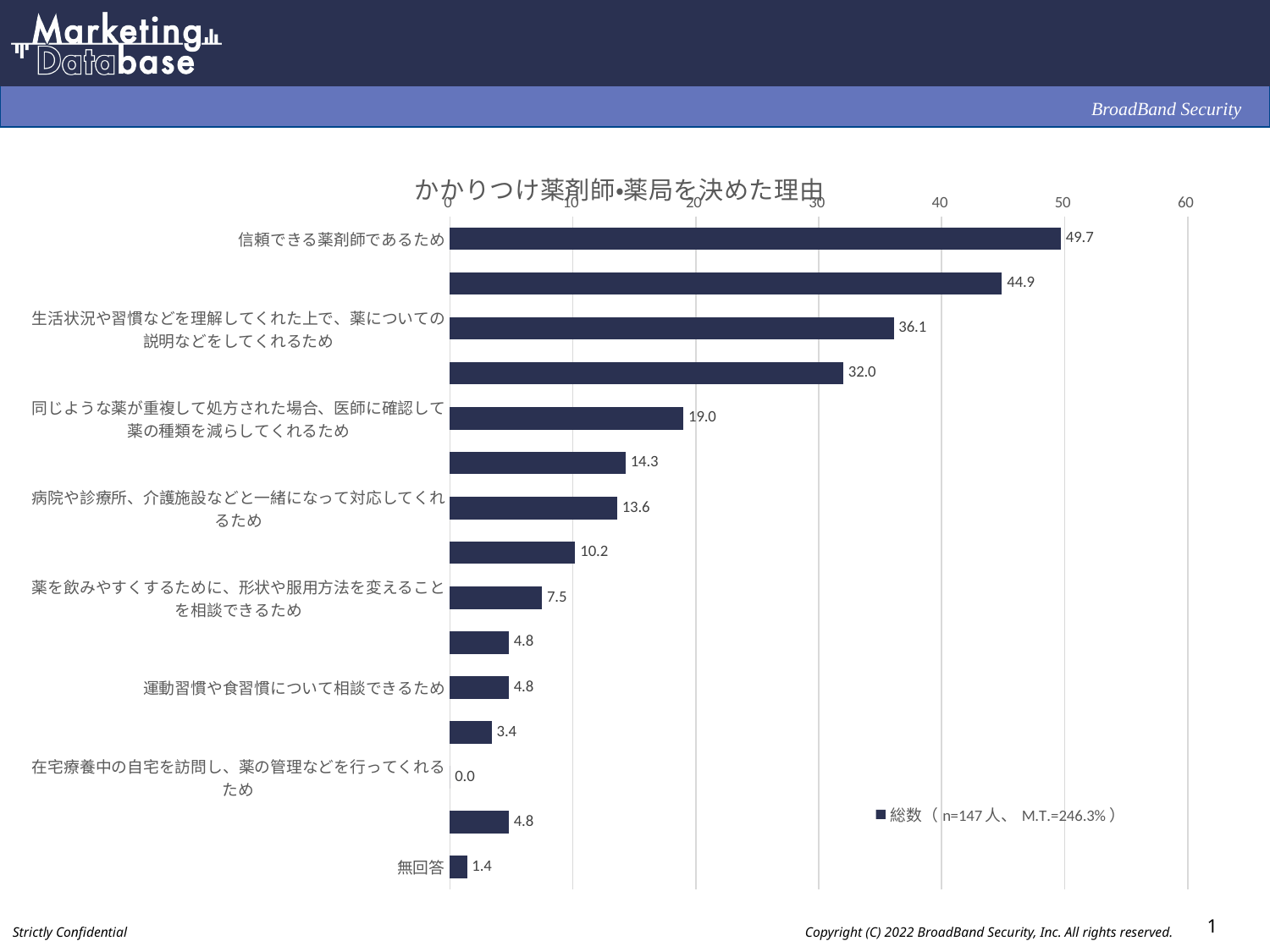
What is the value for 無回答? 1.4 What is the value for 生活状況や習慣などを理解してくれた上で、薬についての説明などをしてくれるため? 36.1 What is the difference between the values for 信頼できる薬剤師であるため and 生活状況や習慣などを理解してくれた上で、薬についての説明などをしてくれるため? 13.6 What is the value for 病院や診療所、介護施設などと一緒になって対応してくれるため? 13.6 What is the title of the chart? かかりつけ薬剤師•薬局を決めた理由 What is the value for 信頼できる薬剤師であるため? 49.7 How many series does the legend list? 1 What type of chart is shown on the slide? bar chart Which category has the highest value? 信頼できる薬剤師であるため How many bars are plotted in the chart? 15 Which is larger: the value for 同じような薬が重複して処方された場合、医師に確認して薬の種類を減らしてくれるため or the value for 病院や診療所、介護施設などと一緒になって対応してくれるため? 同じような薬が重複して処方された場合、医師に確認して薬の種類を減らしてくれるため Which category has the lowest value? 在宅療養中の自宅を訪問し、薬の管理などを行ってくれるため